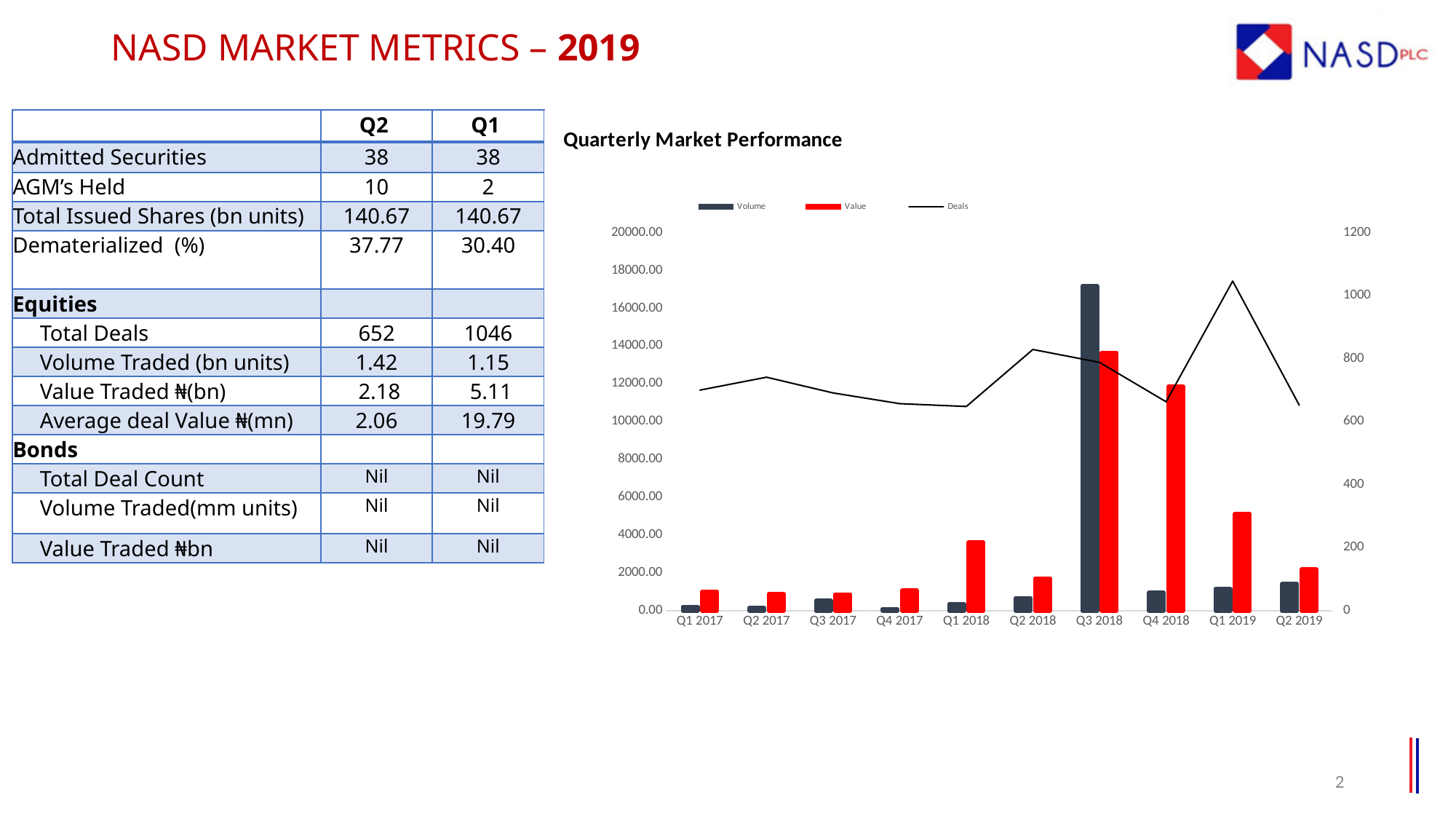
In the Quarterly Market Performance chart, which series is shown in red? Value How many series does the legend of the Quarterly Market Performance chart list? 3 What kind of chart is the Quarterly Market Performance chart? Bar chart with a line series In the Quarterly Market Performance chart, is the Value bar for Q1 2018 greater or less than 4000.00? less In the Quarterly Market Performance chart, is the Deals value for Q1 2019 greater or less than 1000 on the right axis? greater In the Quarterly Market Performance chart, which is larger: the Value bar for Q1 2019 or the Value bar for Q2 2019? Q1 2019 What is the title of the chart on the slide? Quarterly Market Performance In the Quarterly Market Performance chart, which quarter has the highest Value bar? Q3 2018 How many quarters are shown on the x axis of the Quarterly Market Performance chart? 10 In the Quarterly Market Performance chart, is the Volume value for Q3 2018 greater or less than 16000.00? greater In the Quarterly Market Performance chart, which quarter has the highest Volume bar? Q3 2018 In the Quarterly Market Performance chart, in which quarter does the Deals line reach its peak? Q1 2019